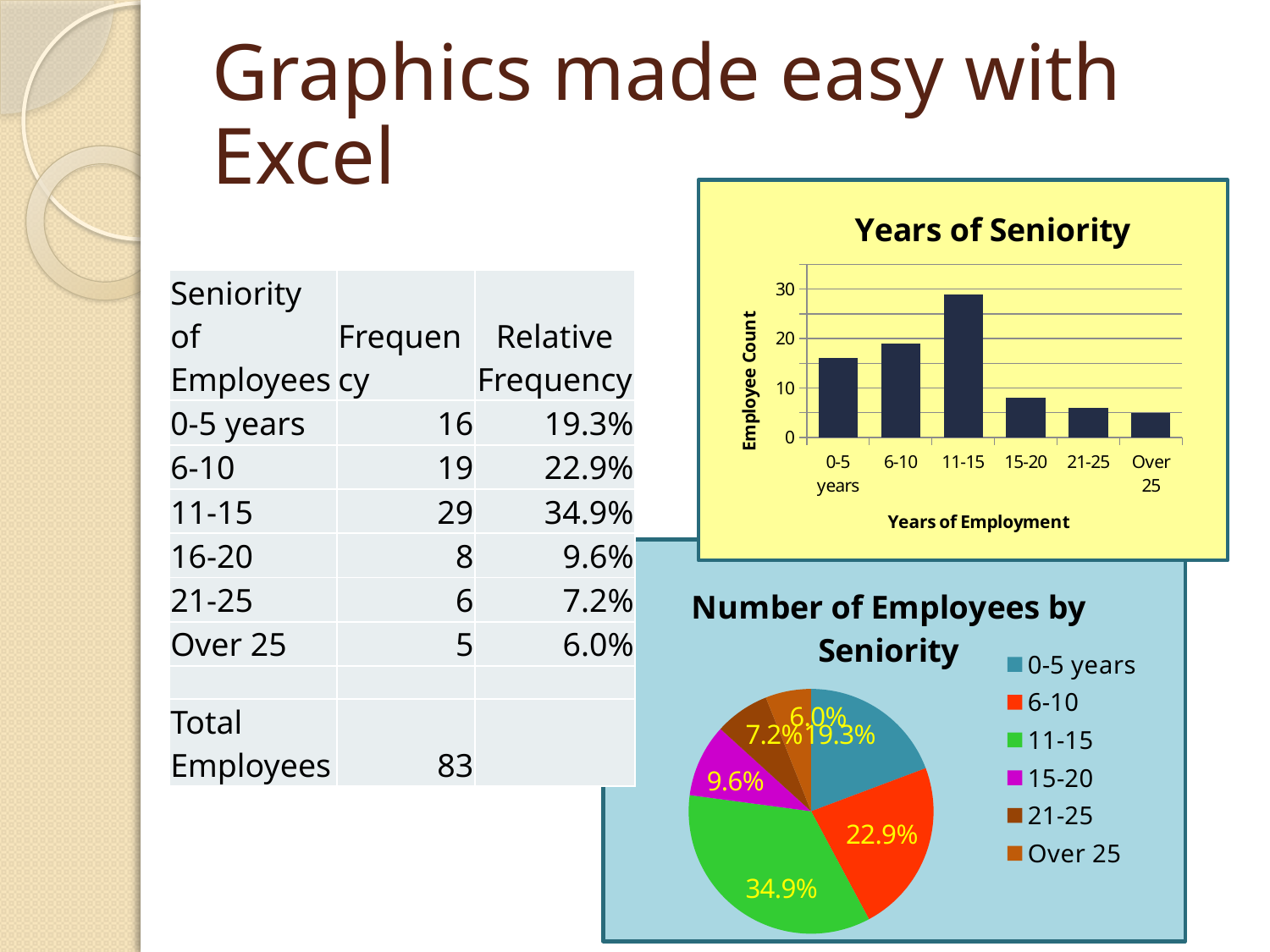
In the 'Years of Seniority' bar chart, is the value for 0-5 years greater or less than 10? greater In the 'Years of Seniority' bar chart, how many categories are shown on the x axis? 6 How many entries does the legend of the 'Number of Employees by Seniority' pie chart list? 6 What is the y-axis title of the 'Years of Seniority' bar chart? Employee Count In the 'Number of Employees by Seniority' pie chart, what share is labelled for the 11-15 slice? 34.9% In the 'Years of Seniority' bar chart, is the value for 11-15 greater or less than 20? greater In the 'Years of Seniority' bar chart, which is larger, the bar for 6-10 or the bar for 15-20? 6-10 What kind of chart is the 'Years of Seniority' chart? bar chart In the 'Years of Seniority' bar chart, which category has the lowest employee count? Over 25 In the 'Number of Employees by Seniority' pie chart, what percentage is shown for 6-10? 22.9% In the 'Number of Employees by Seniority' pie chart, what is the difference between the 6-10 share and the 0-5 years share? 3.6% In the 'Years of Seniority' bar chart, which category has the highest employee count? 11-15